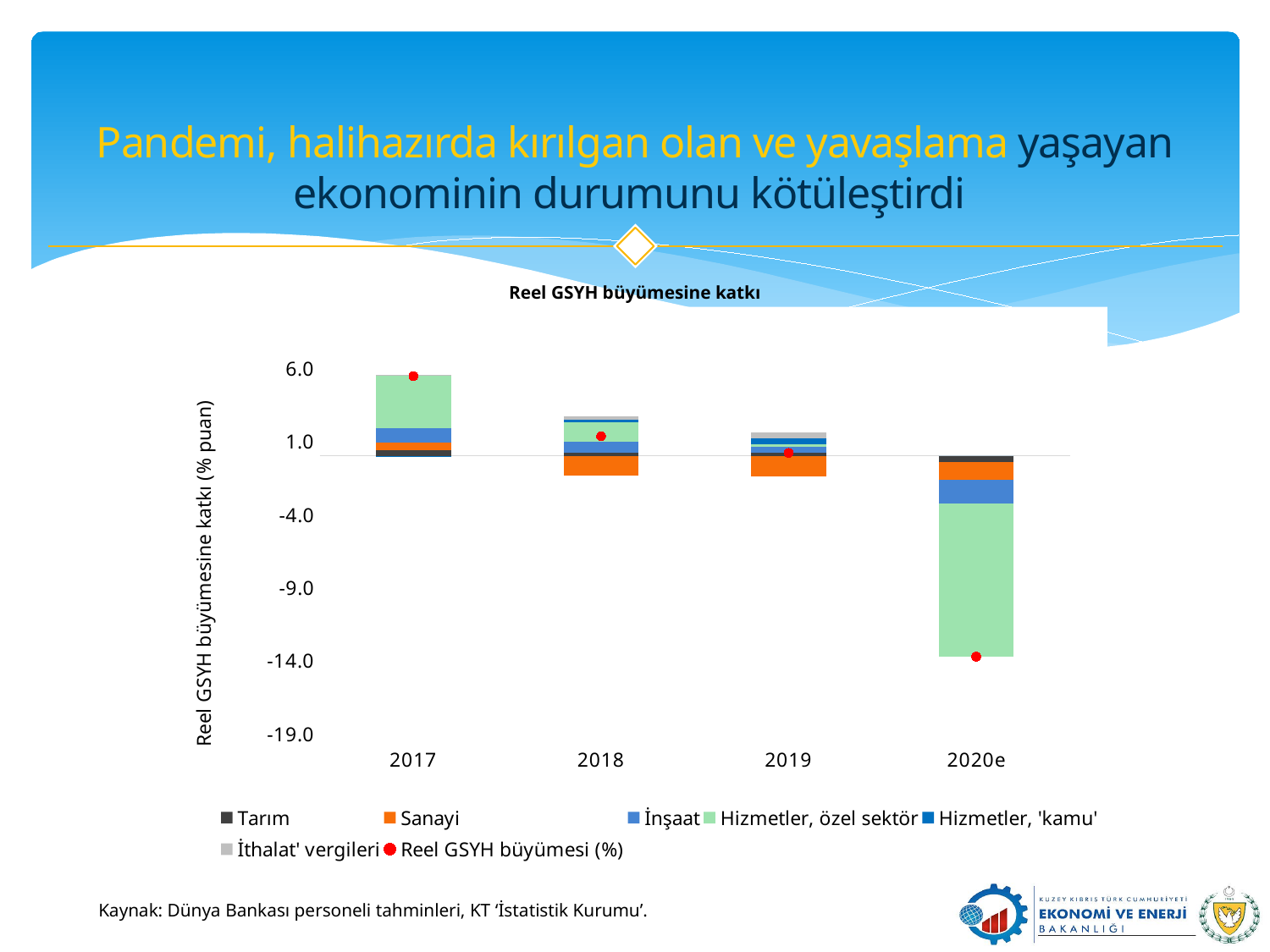
Does the Reel GSYH büyümesi (%) rise or fall from 2017 to 2020e? Fall How many years (categories) are shown on the x axis of the chart? 4 Is the Reel GSYH büyümesi (%) value for 2017 greater or less than 1.0? greater What kind of chart is shown on the slide? Stacked bar chart with markers What is the label of the vertical axis of the chart? Reel GSYH büyümesine katkı (% puan) How many series does the chart legend list? 7 Which series makes the largest negative contribution in 2020e? Hizmetler, özel sektör What is the title of the chart? Reel GSYH büyümesine katkı Which is larger, the Reel GSYH büyümesi (%) for 2017 or for 2020e? 2017 Which year has the highest Reel GSYH büyümesi (%) marker? 2017 Is the Reel GSYH büyümesi (%) value for 2020e greater or less than -9.0? less Which year has the lowest Reel GSYH büyümesi (%) marker? 2020e